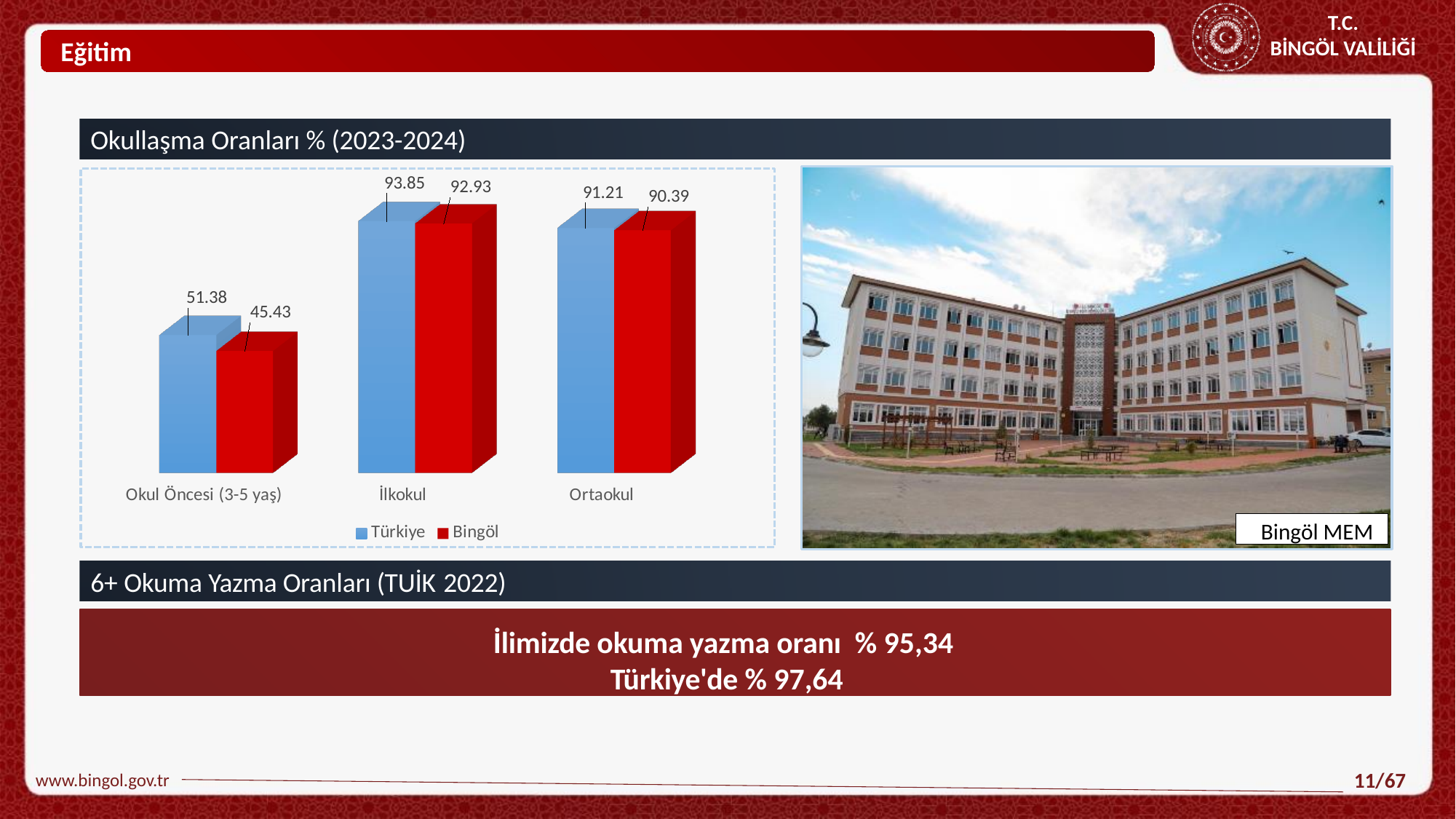
What is the Türkiye value for Okul Öncesi (3-5 yaş)? 51.38 What is the Bingöl value for Okul Öncesi (3-5 yaş)? 45.43 What is the Bingöl value for İlkokul? 92.93 How many series does the chart legend list? 2 Which category has the highest Türkiye value? İlkokul What kind of chart is shown on the slide? Bar chart What is the difference between the Türkiye and Bingöl values for Okul Öncesi (3-5 yaş)? 5.95 What is the Türkiye value for Ortaokul? 91.21 What is the difference between the Türkiye and Bingöl values for Ortaokul? 0.82 Which is larger for İlkokul, the Türkiye value or the Bingöl value? Türkiye How many categories are shown on the x axis of the chart? 3 Which category has the lowest Bingöl value? Okul Öncesi (3-5 yaş)